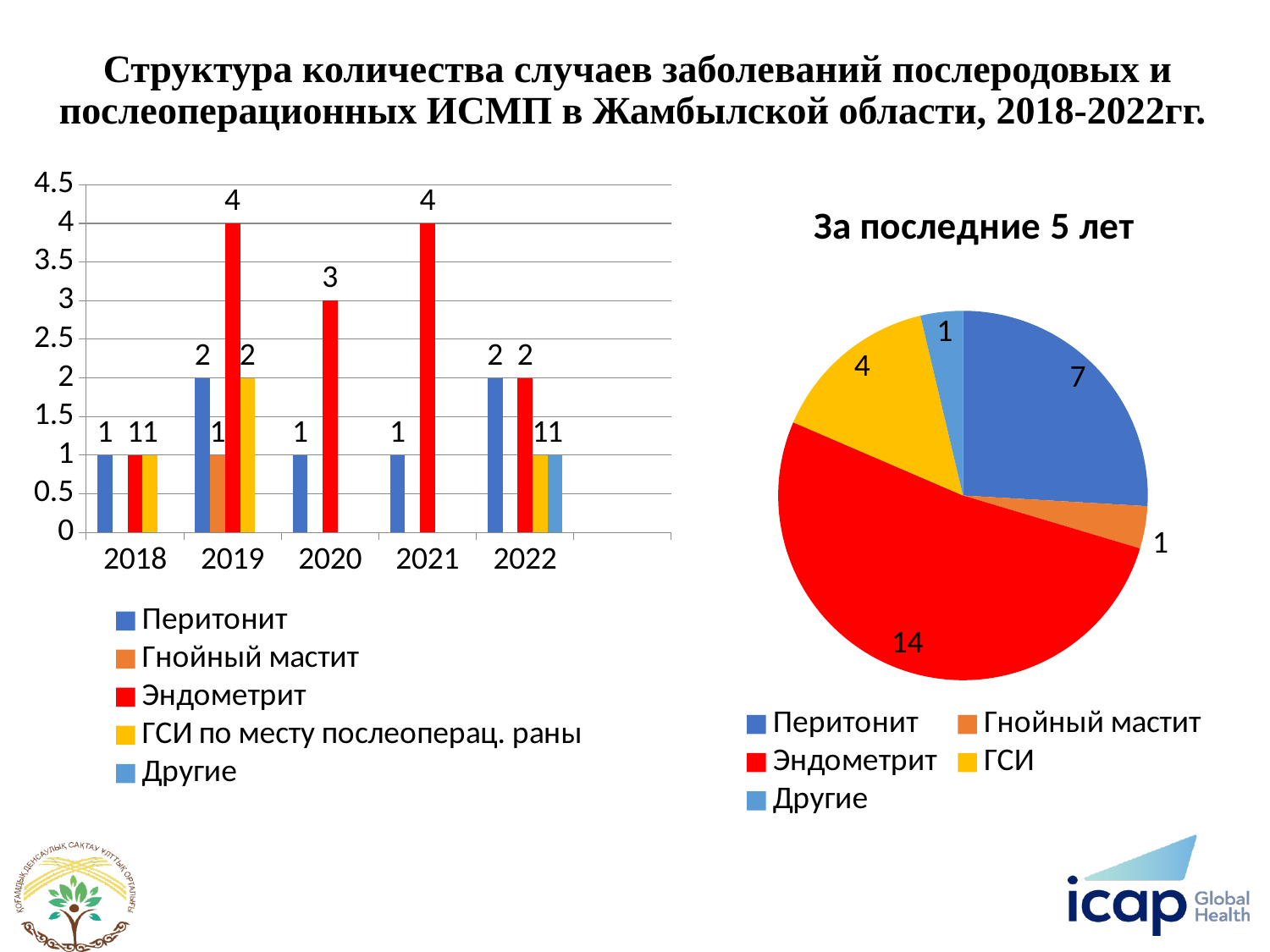
In the bar chart on the left, what is the value for Перитонит in 2022? 2 In the bar chart on the left, how many years are shown on the x axis? 5 In the bar chart on the left, what is the difference between the Эндометрит value in 2019 and in 2022? 2 What kind of chart is the chart on the right titled 'За последние 5 лет'? pie chart In the pie chart 'За последние 5 лет', which category has the largest slice? Эндометрит In the bar chart on the left, how many series does the legend list? 5 In the bar chart on the left, what is the value for Эндометрит in 2019? 4 In the bar chart on the left, which year has the highest value for Эндометрит, 2020 or 2021? 2021 In the pie chart 'За последние 5 лет', what is the value for Эндометрит? 14 In the pie chart 'За последние 5 лет', what is the difference between the Перитонит value and the ГСИ value? 3 What kind of chart is the chart on the left? bar chart In the bar chart on the left, what is the value for Эндометрит in 2020? 3